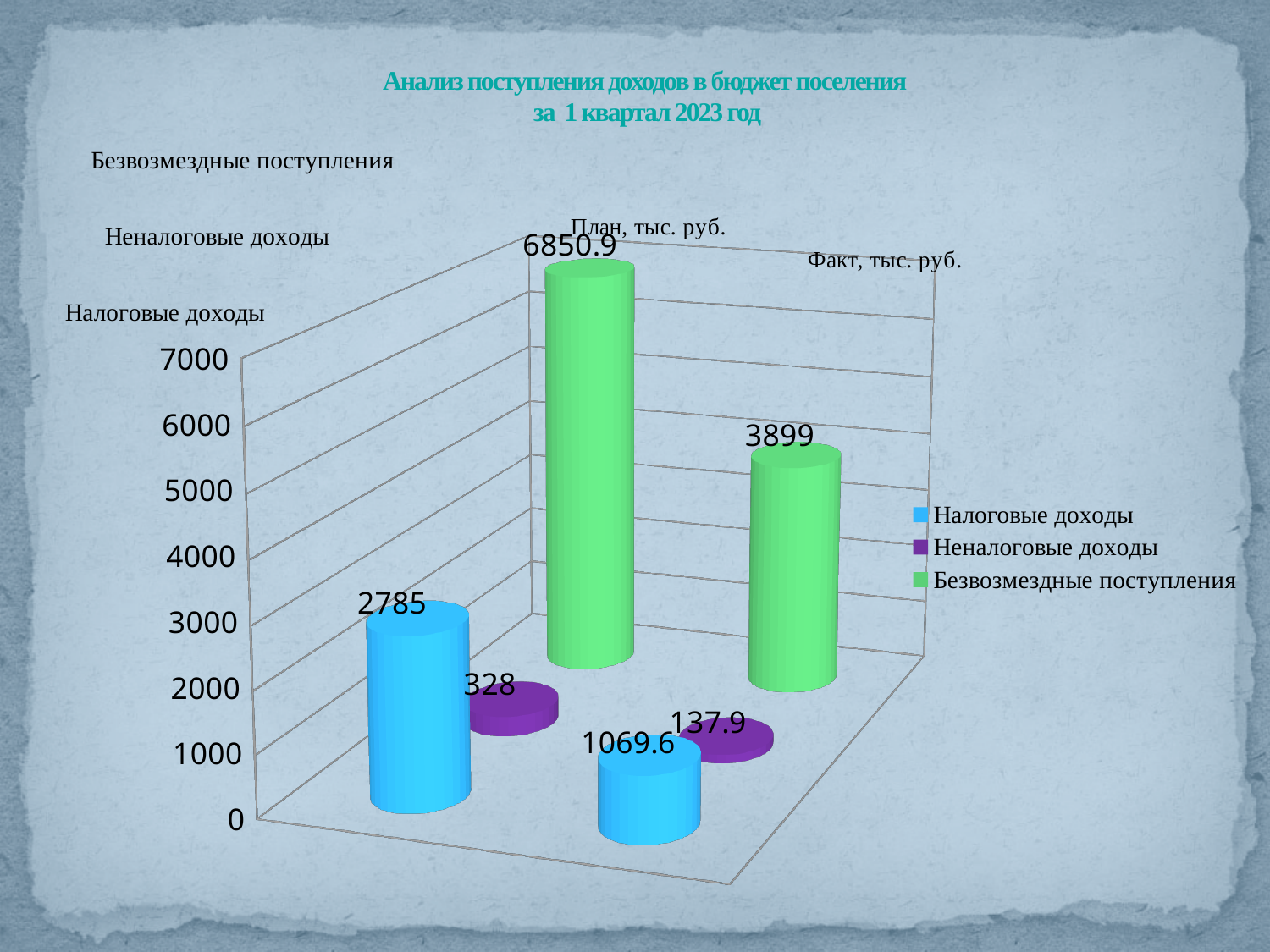
What is the actual value (Факт, тыс. руб.) for Налоговые доходы? 1069.6 Which series has the lowest actual value (Факт, тыс. руб.)? Неналоговые доходы What is the planned value (План, тыс. руб.) for Неналоговые доходы? 328 What is the actual value (Факт, тыс. руб.) for Безвозмездные поступления? 3899 What is the planned value (План, тыс. руб.) for Налоговые доходы? 2785 What is the difference between the planned and actual values for Налоговые доходы? 1715.4 What kind of chart is shown on the slide? Bar chart Which series has the highest planned value (План, тыс. руб.)? Безвозмездные поступления Which is larger: the planned value for Налоговые доходы or the actual value for Безвозмездные поступления? Actual value for Безвозмездные поступления What is the difference between the planned and actual values for Безвозмездные поступления? 2951.9 What colour represents Неналоговые доходы in the chart? Purple How many series does the legend list? 3